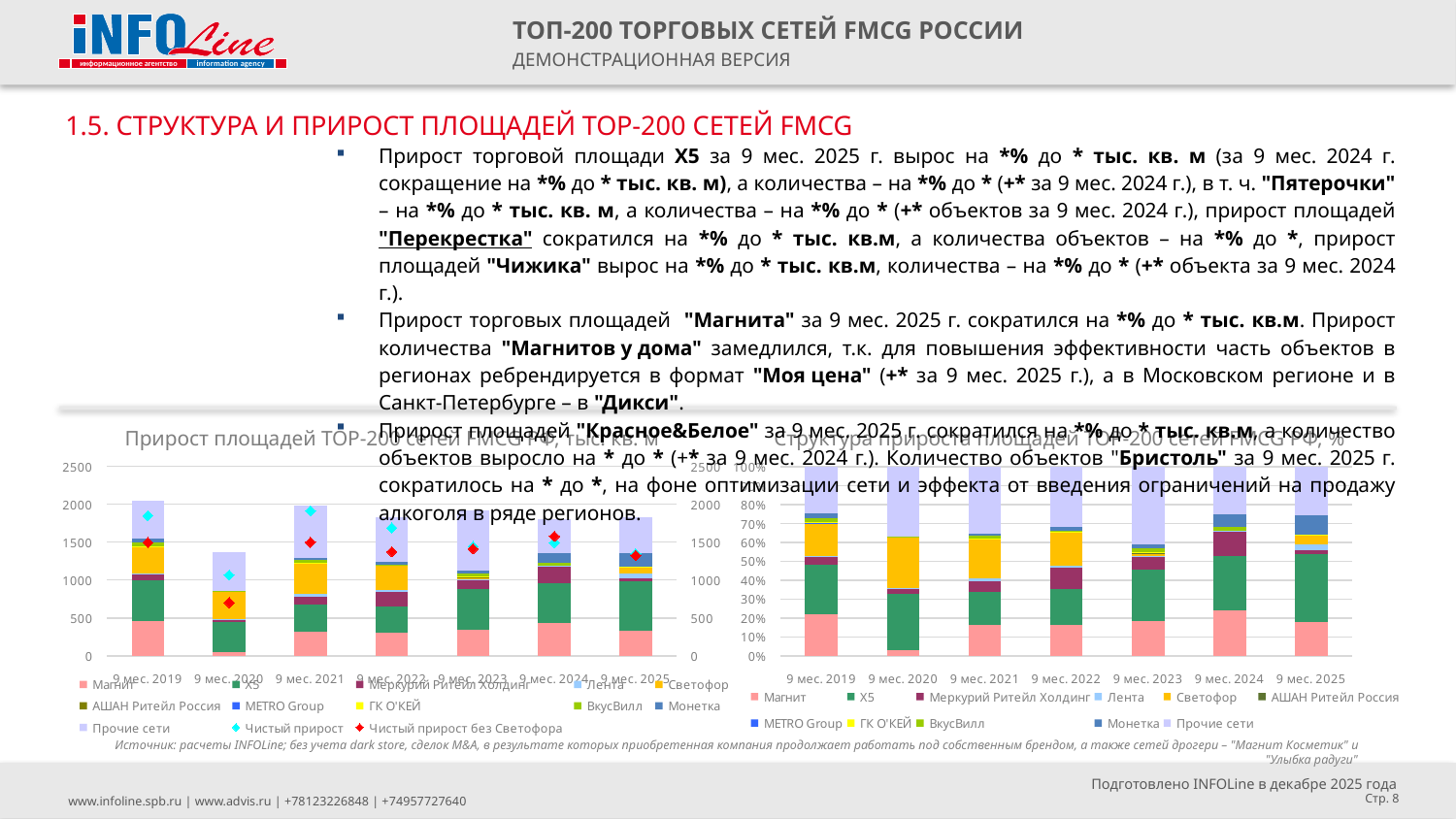
In the left chart "Прирост площадей TOP-200 сетей FMCG РФ, тыс. кв. м", is the total height of the stacked bar for 9 мес. 2022 greater or less than 1500? greater What kind of chart is the left chart titled "Прирост площадей TOP-200 сетей FMCG РФ, тыс. кв. м"? Combination chart: stacked bars with two line series shown as diamond markers In the right chart "Структура прироста площадей TOP-200 сетей FMCG РФ, %", is the share of Магнит for 9 мес. 2020 greater or less than 10%? less How many entries does the legend of the left chart "Прирост площадей TOP-200 сетей FMCG РФ, тыс. кв. м" list? 13 In the left chart "Прирост площадей TOP-200 сетей FMCG РФ, тыс. кв. м", is the total height of the stacked bar for 9 мес. 2020 greater or less than 1500? less What unit is stated in the title of the left chart on the slide? тыс. кв. м How many entries does the legend of the right chart "Структура прироста площадей TOP-200 сетей FMCG РФ, %" list? 11 How many periods (categories) are shown on the x axis of the right chart "Структура прироста площадей TOP-200 сетей FMCG РФ, %"? 7 How many periods (categories) are shown on the x axis of the left chart "Прирост площадей TOP-200 сетей FMCG РФ, тыс. кв. м"? 7 Which two legend entries in the left chart "Прирост площадей TOP-200 сетей FMCG РФ, тыс. кв. м" are shown as diamond markers rather than bar segments? Чистый прирост and Чистый прирост без Светофора In the right chart "Структура прироста площадей TOP-200 сетей FMCG РФ, %", which period has the larger share for Магнит: 9 мес. 2019 or 9 мес. 2020? 9 мес. 2019 In the left chart "Прирост площадей TOP-200 сетей FMCG РФ, тыс. кв. м", which stacked bar is taller: 9 мес. 2019 or 9 мес. 2020? 9 мес. 2019